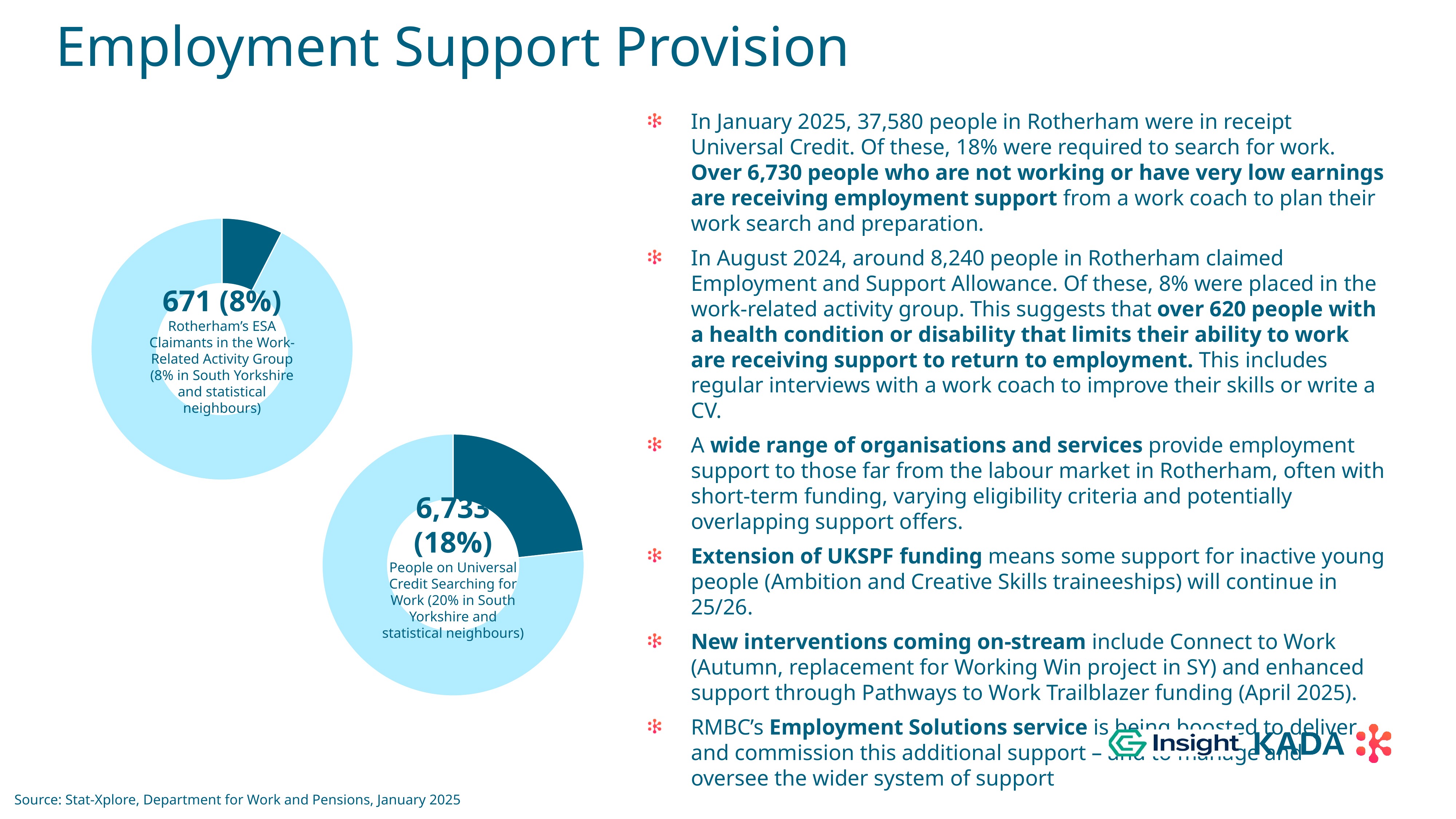
In the upper chart, what share of Rotherham's ESA claimants are in the Work-Related Activity Group? 8% In the upper chart, how many of Rotherham's ESA claimants are in the Work-Related Activity Group? 671 How many charts are shown on the slide? 2 According to the lower chart's label, what is the comparable share of people on Universal Credit searching for work in South Yorkshire and statistical neighbours? 20% What is the difference in percentage points between the Universal Credit searching for work share (lower chart) and the ESA Work-Related Activity Group share (upper chart)? 10 percentage points According to the upper chart's label, what is the comparable share of ESA claimants in the Work-Related Activity Group in South Yorkshire and statistical neighbours? 8% In the lower chart, what share of people on Universal Credit in Rotherham are searching for work? 18% Which highlighted share is larger: ESA claimants in the Work-Related Activity Group (upper chart) or people on Universal Credit searching for work (lower chart)? People on Universal Credit searching for work (18%) What kind of chart is used on the left side of the slide to show Rotherham's ESA claimants in the Work-Related Activity Group? pie chart (donut)